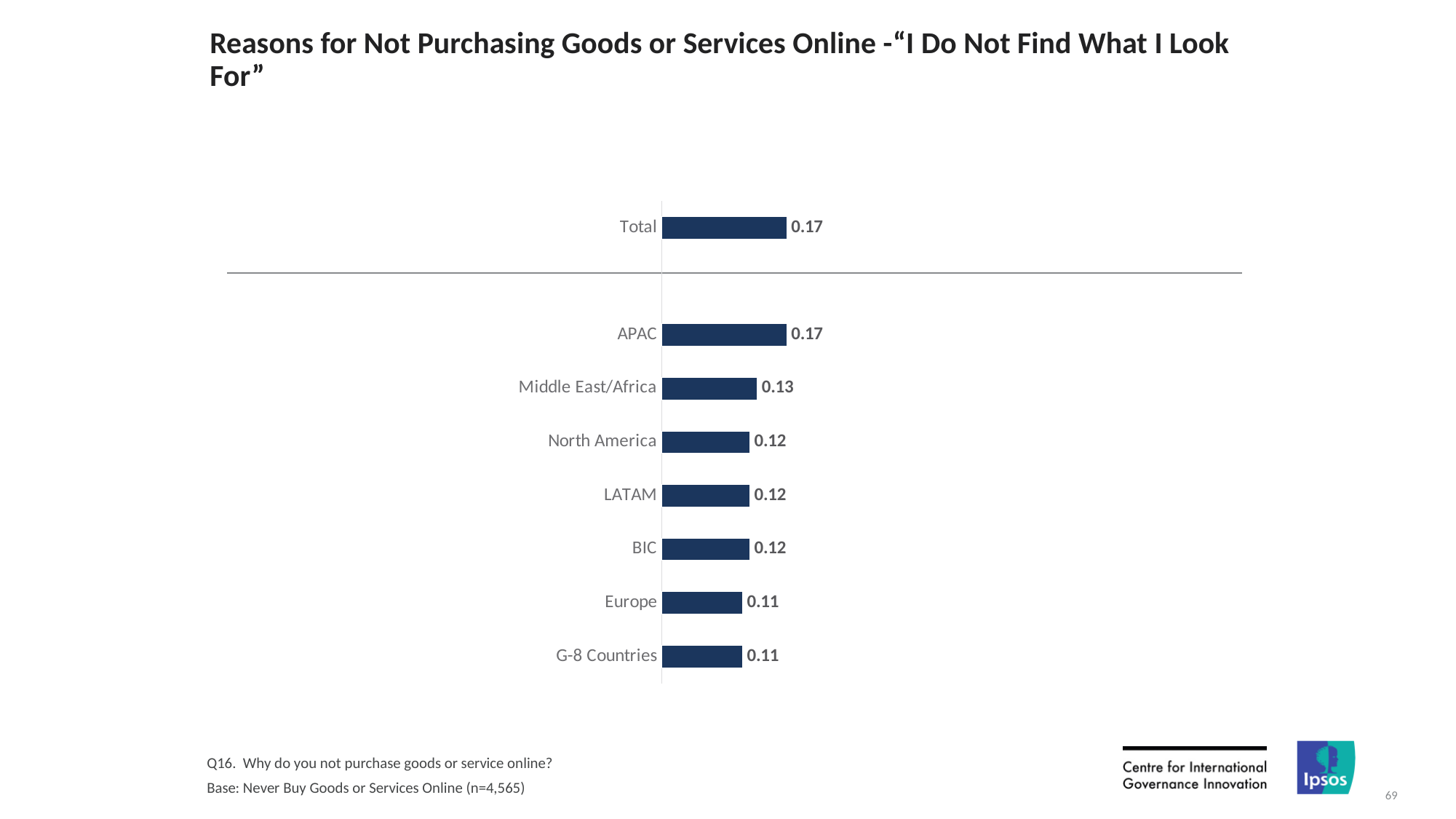
Which is larger, the value for APAC or the value for Europe? APAC What kind of chart is shown on the slide? Bar chart What is the difference between the values for APAC and Middle East/Africa? 0.04 What is the base sample size stated on the slide? n=4,565 How many categories are shown in the chart? 8 What is the difference between the values for Total and G-8 Countries? 0.06 What is the value for Europe? 0.11 What is the value for Total? 0.17 Which region has the highest value? APAC What is the value for Middle East/Africa? 0.13 Which is larger, the value for Middle East/Africa or the value for BIC? Middle East/Africa What is the value for North America? 0.12